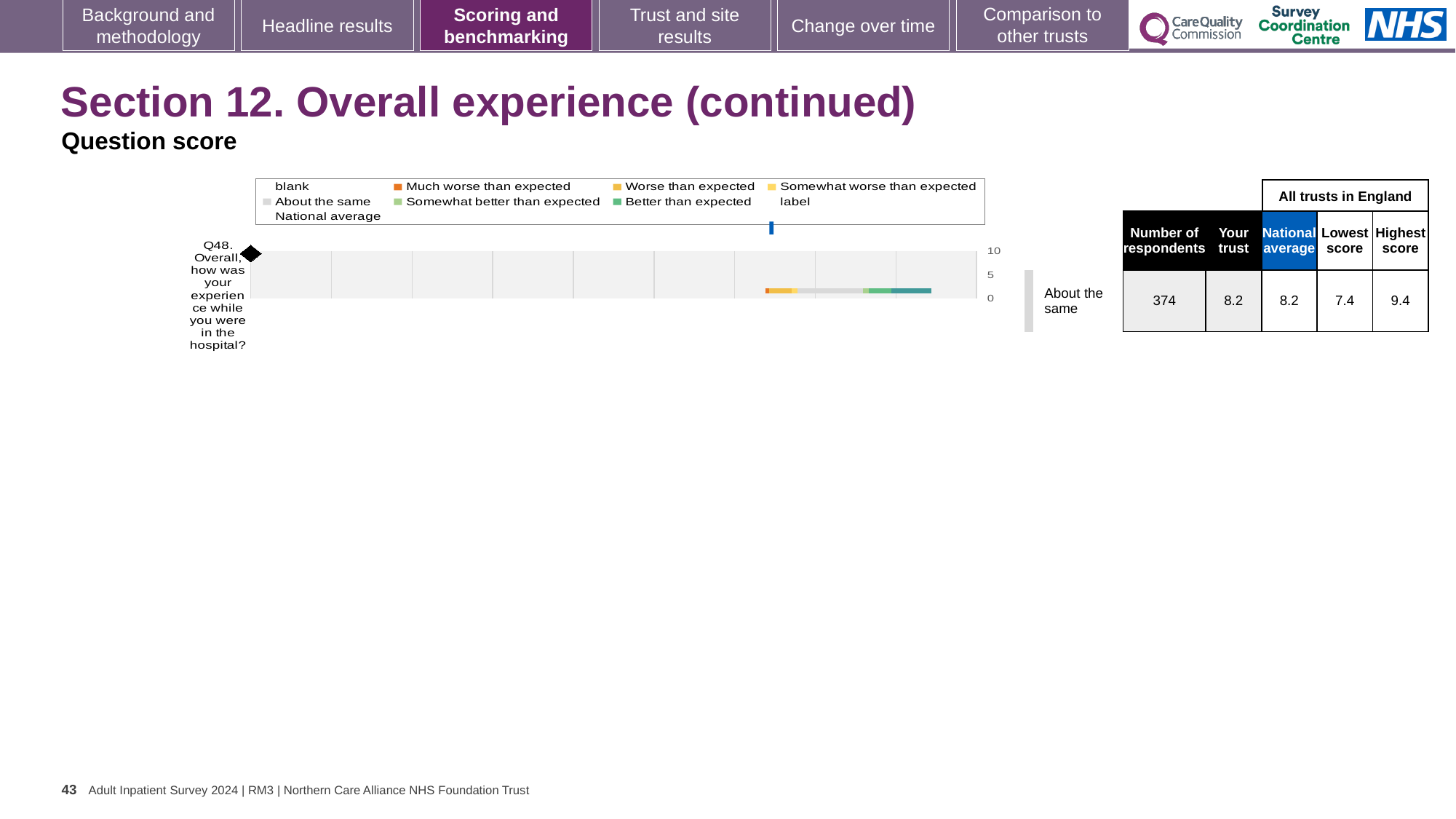
What is the difference between the highest score and the lowest score for Q48? 2.0 What is the maximum value shown on the chart's score axis? 10 By how much does the 'Your trust' score for Q48 exceed the lowest score in England? 0.8 How many survey questions are plotted on the chart? 1 How many respondents answered Q48 according to the table next to the chart? 374 What is the national average score for Q48? 8.2 What is the lowest score among all trusts in England for Q48? 7.4 What is the 'Your trust' score for Q48 (Overall, how was your experience while you were in the hospital?)? 8.2 Which benchmark category is the trust's Q48 result placed in? About the same What kind of chart is used to show the Q48 question score? Bar chart Is the 'Your trust' score for Q48 larger than the national average? No, both are 8.2 What is the highest score among all trusts in England for Q48? 9.4